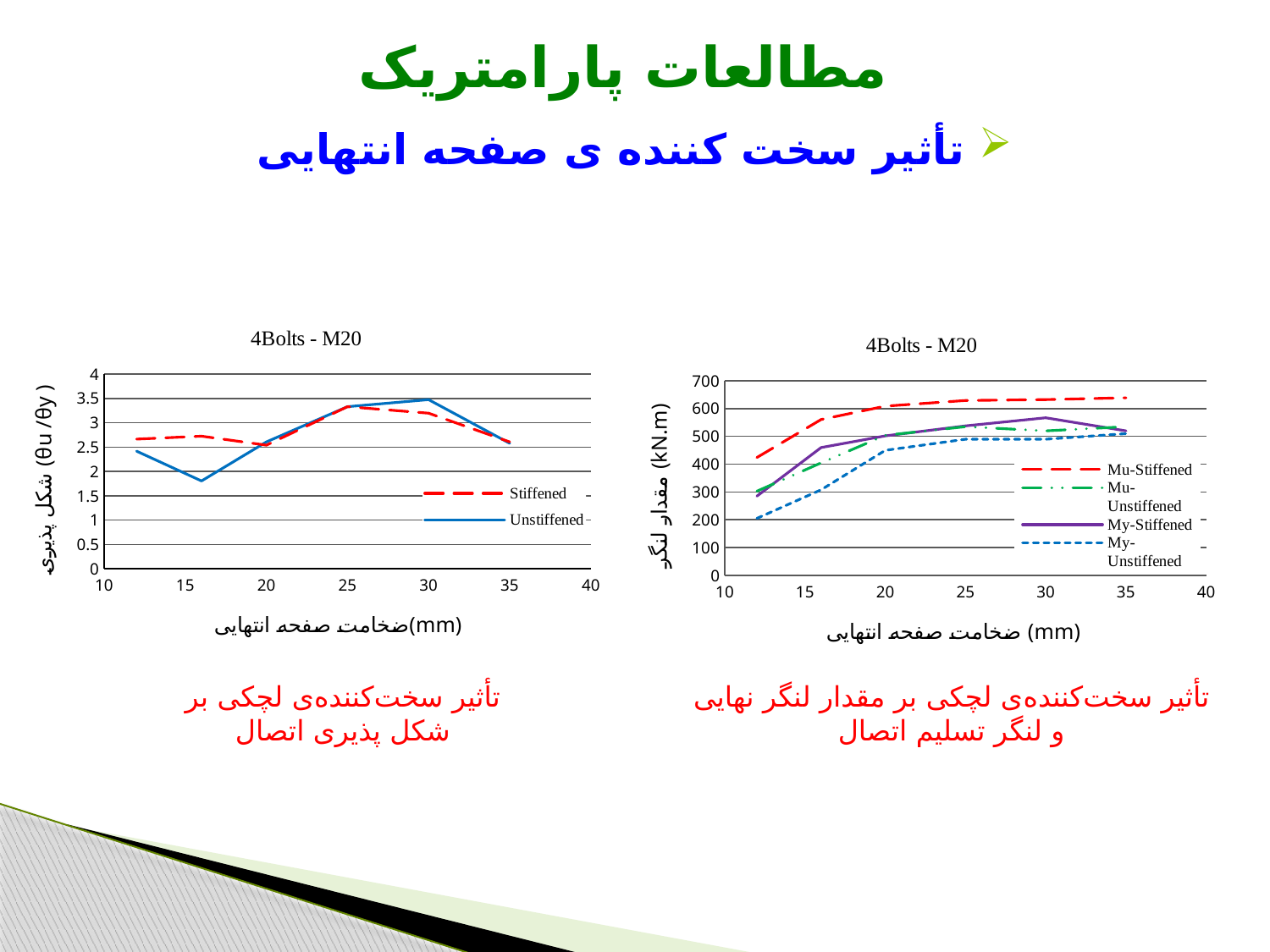
On the right chart (moment), how many series does the legend list? 4 On the left chart (ductility), is the Stiffened value at 12 mm greater or less than 2.5? greater On the left chart (ductility), which series has the larger value at 16 mm, Stiffened or Unstiffened? Stiffened On the right chart (moment), is the Mu-Stiffened value at 35 mm greater or less than 600? greater On the left chart (ductility), how many series does the legend list? 2 On the right chart (moment), which series has the lowest value at 12 mm? My-Unstiffened What is the title of the right chart? 4Bolts - M20 On the left chart (ductility), which series has the larger value at 30 mm, Stiffened or Unstiffened? Unstiffened On the left chart (ductility), what kind of chart is it? line chart On the right chart (moment), does the Mu-Stiffened series rise or fall as end plate thickness increases from 12 mm to 35 mm? rise On the right chart (moment), is the Mu-Stiffened value at 12 mm greater or less than 400? greater